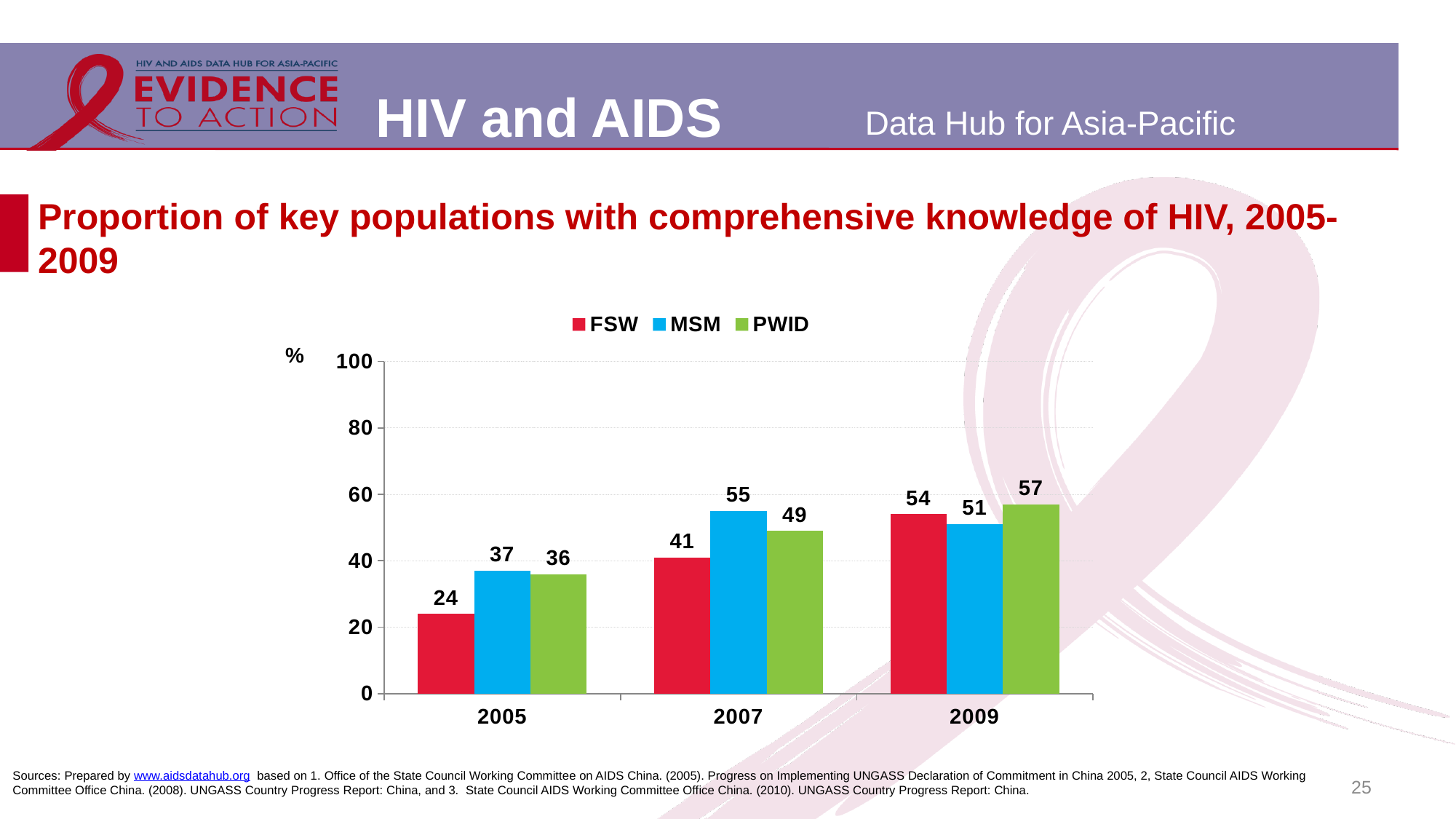
Do the FSW values rise or fall from 2005 to 2009? Rise What is the value for MSM in 2007? 55 What is the value for FSW in 2005? 24 Which key population has the lowest value in 2005? FSW Which colour represents MSM in the chart? Blue What is the value for PWID in 2009? 57 Which is larger in 2007, the value for MSM or the value for PWID? MSM What kind of chart is shown on the slide? Bar chart What is the difference between the FSW values in 2009 and 2005? 30 How many years are shown on the x axis? 3 How many series does the legend list? 3 Which key population has the highest value in 2009? PWID